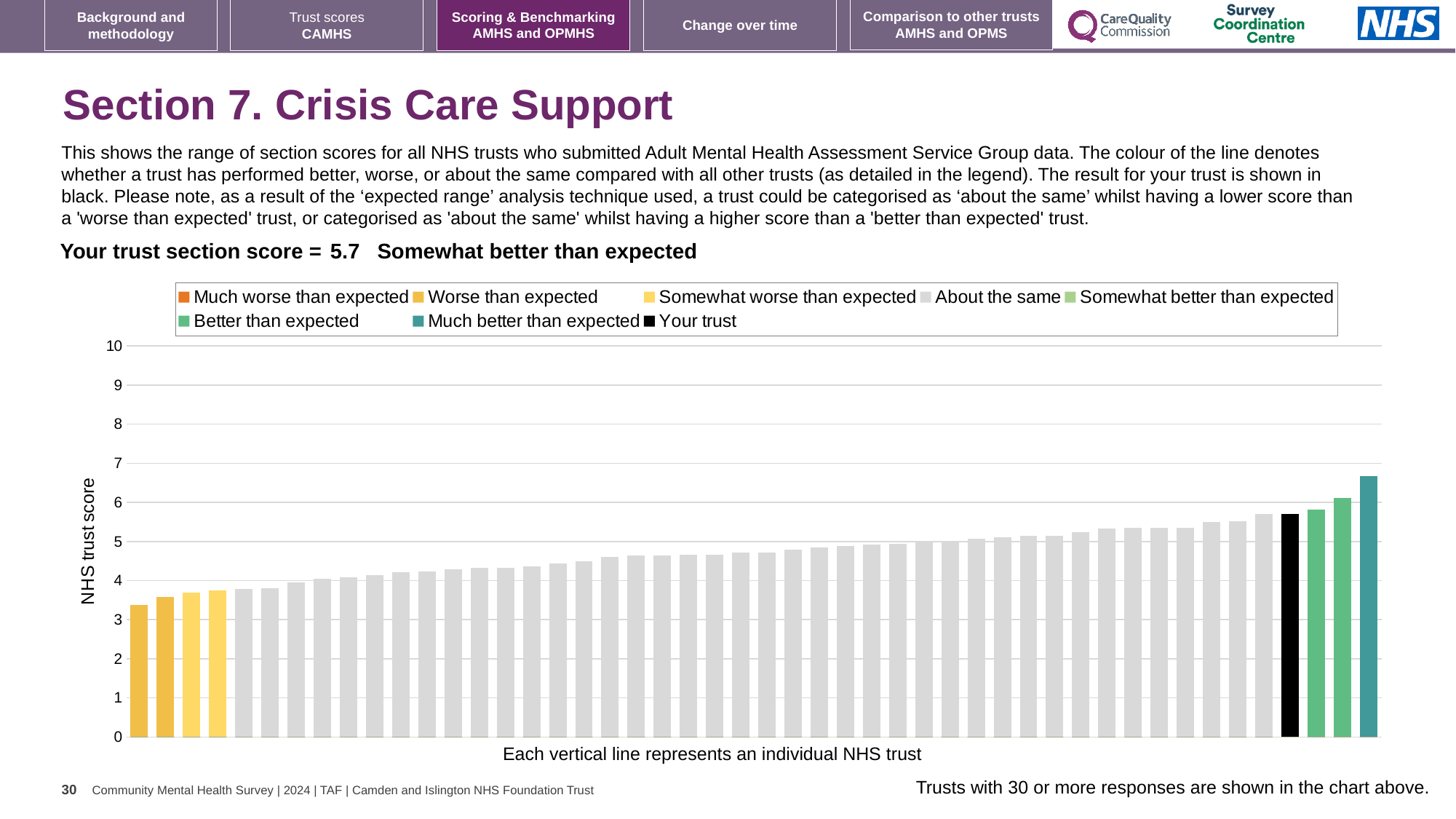
How many entries does the chart legend list? 8 Which is larger: the value of the 'Your trust' bar or the value of the rightmost bar? the rightmost bar Do the bar values rise or fall from left to right along the x axis? rise What is the title of the y axis? NHS trust score Is the value of the tallest bar greater or less than 6? greater How many bars are coloured as 'Much better than expected'? 1 Is the value of the black 'Your trust' bar greater or less than 5? greater Which legend category does the tallest bar belong to? Much better than expected Which legend category does the shortest bar belong to? Worse than expected What is the section score for your trust, as printed on the slide? 5.7 What kind of chart is shown on the slide? bar chart Is the value of the leftmost (lowest) bar greater or less than 4? less